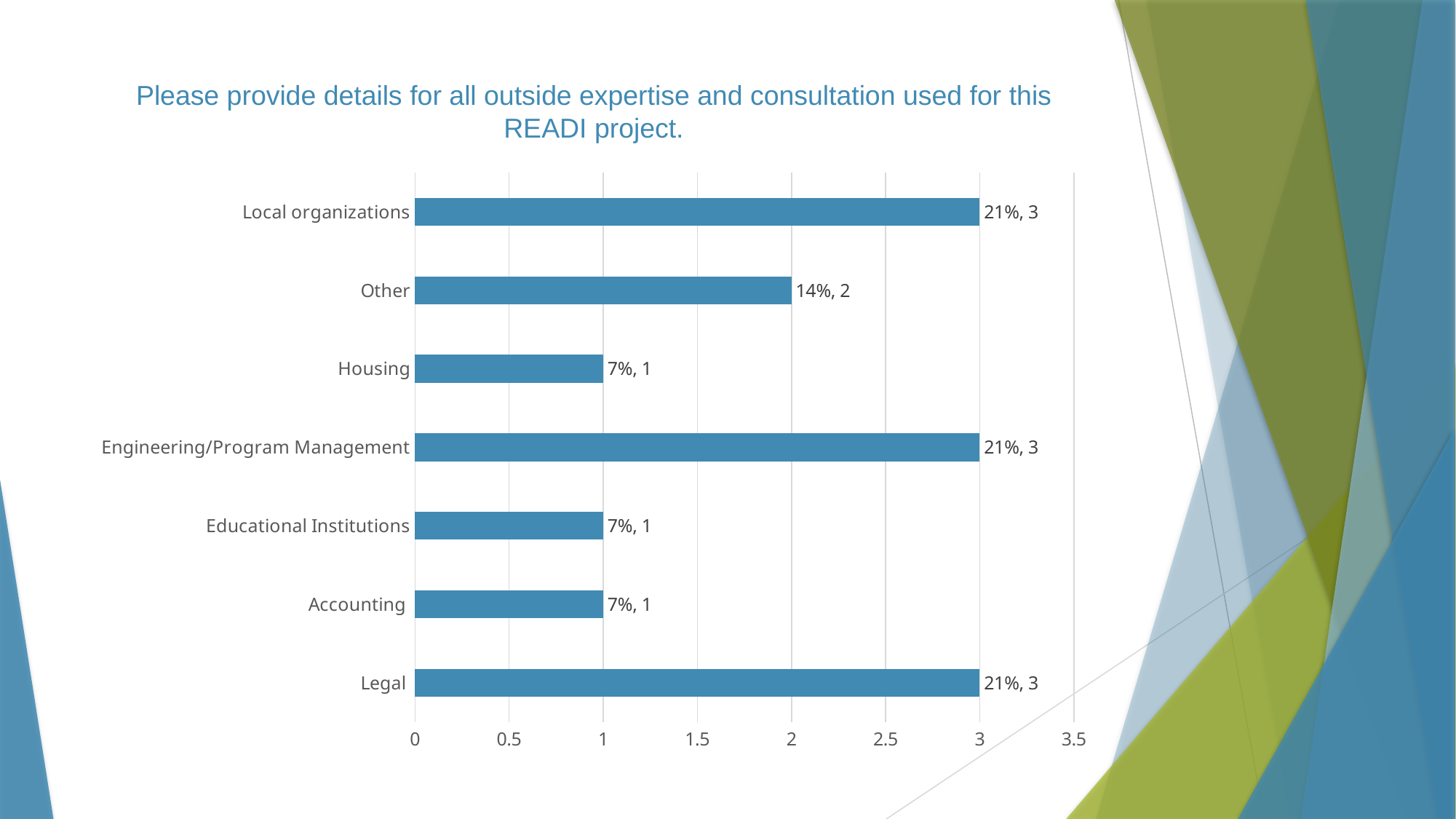
How many categories are shown on the chart? 7 What is the difference in count between Other and Educational Institutions? 1 What percentage is shown for Legal? 21% Is the count for Other greater or less than Housing? greater Which category has the lowest count: Other or Accounting? Accounting What count is shown for Engineering/Program Management? 3 What kind of chart is shown on the slide? bar chart Is the count for Local organizations greater or less than 2? greater What is the difference in count between Local organizations and Other? 1 What is the data label shown for Other? 14%, 2 What count is shown for Housing? 1 What is the title of the chart? Please provide details for all outside expertise and consultation used for this READI project.